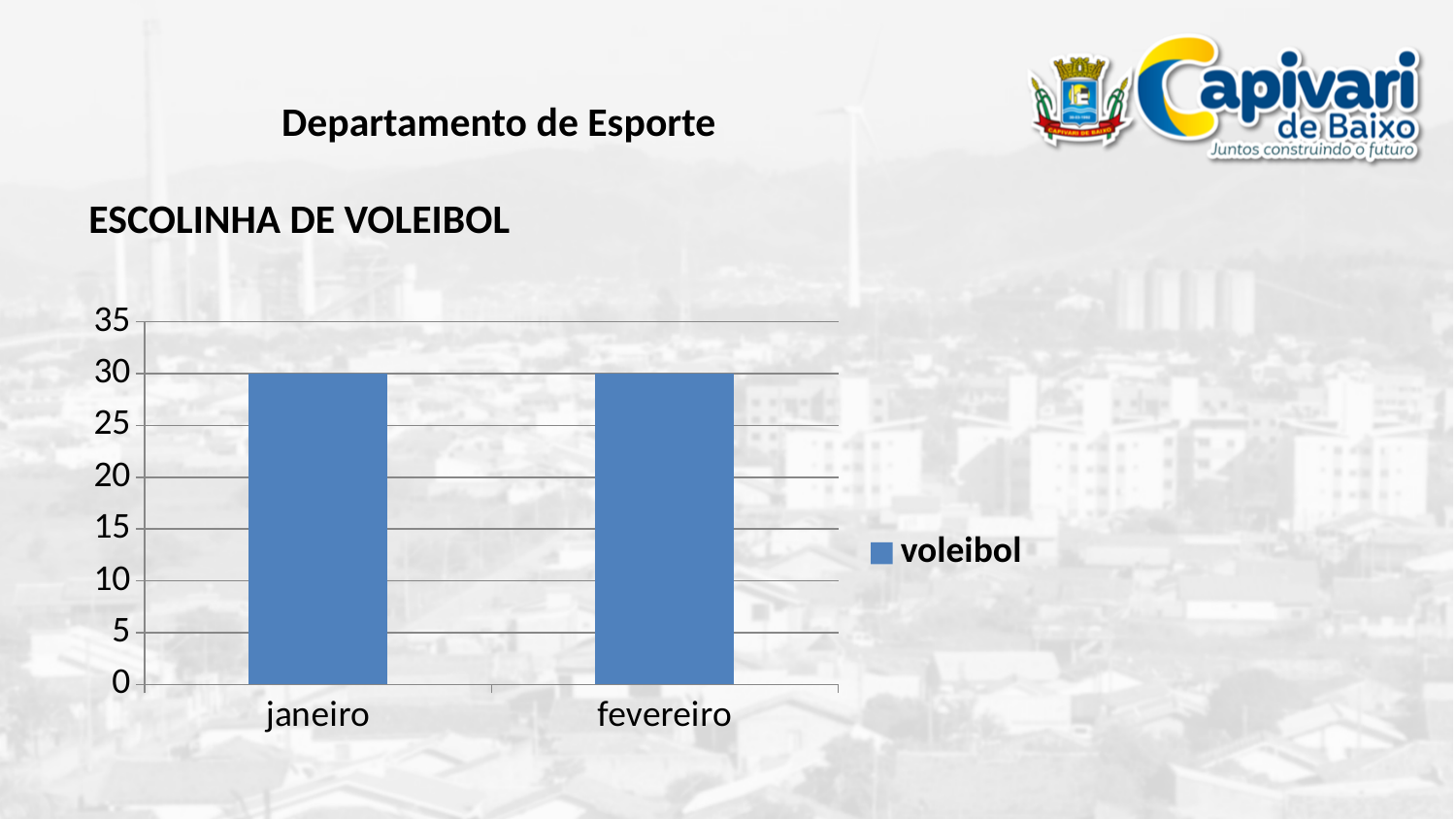
What type of chart is shown on the slide? bar chart Is the value for janeiro greater or less than 25? greater How many series does the legend list? 1 What is the difference between the values for janeiro and fevereiro? 0 Do the values rise, fall or stay the same from janeiro to fevereiro? stay the same How many categories are shown on the x axis? 2 What is the value for janeiro? 30 What is the value for fevereiro? 30 What is the highest value shown on the y axis? 35 What is the name of the series in the legend? voleibol Is the value for fevereiro greater or less than 35? less What is the title of the chart? ESCOLINHA DE VOLEIBOL